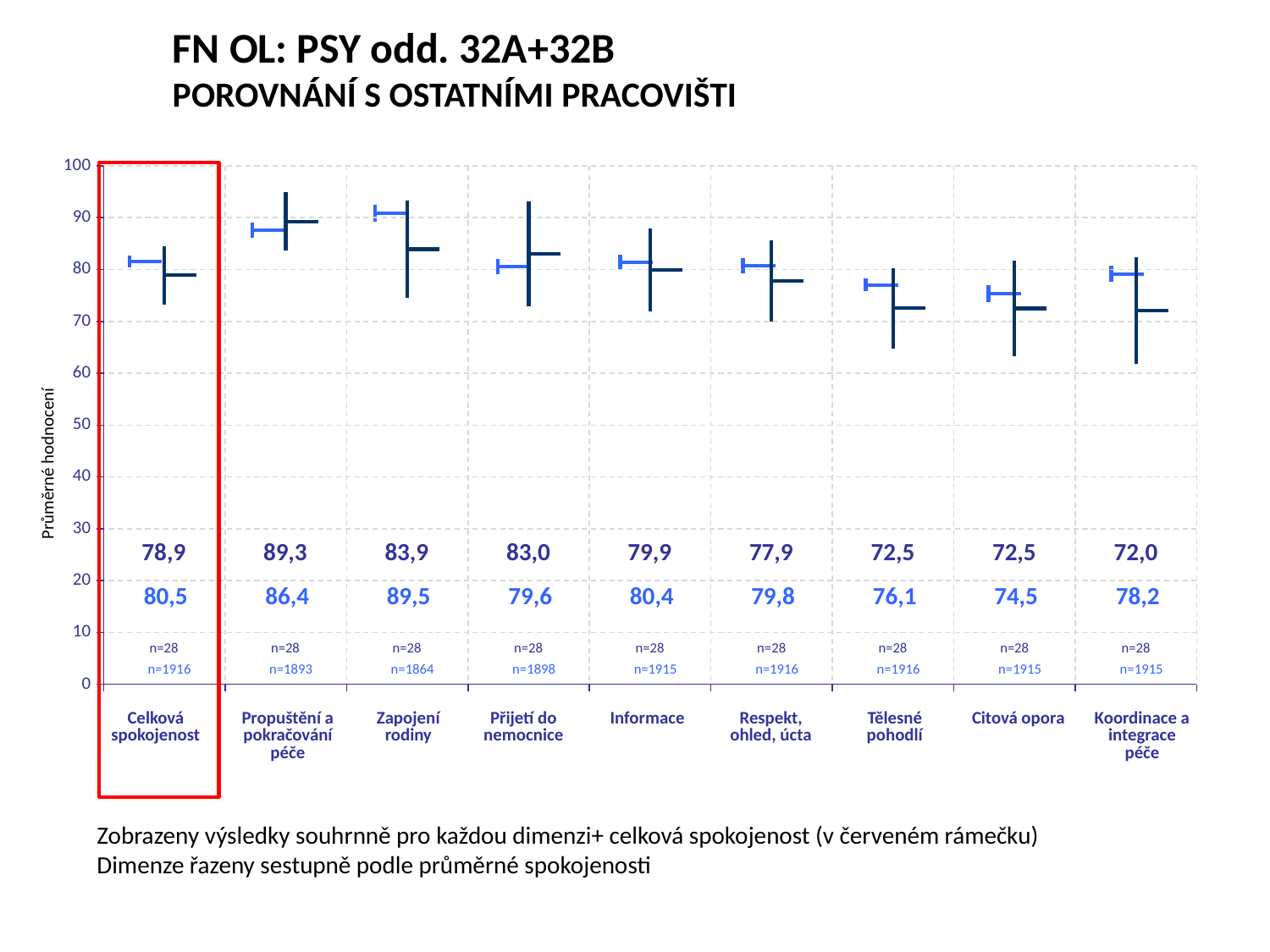
What is the label of the vertical axis of the chart? Průměrné hodnocení For Informace, which is larger: the dark blue value or the light blue value? the light blue value (80,4) For Celková spokojenost, what is the difference between the light blue value (80,5) and the dark blue value (78,9)? 1,6 Which category has the highest dark blue (n=28) value? Propuštění a pokračování péče How many categories are shown along the x axis of the chart? 9 Which category has the lowest light blue value? Citová opora For Zapojení rodiny, what is the difference between the light blue value and the dark blue value? 5,6 Which category has the highest light blue value? Zapojení rodiny What is the light blue value printed for Zapojení rodiny? 89,5 What is the dark blue (n=28) value printed for Tělesné pohodlí? 72,5 What is the dark blue (n=28) value printed for Celková spokojenost? 78,9 Which category has the lowest dark blue (n=28) value? Koordinace a integrace péče